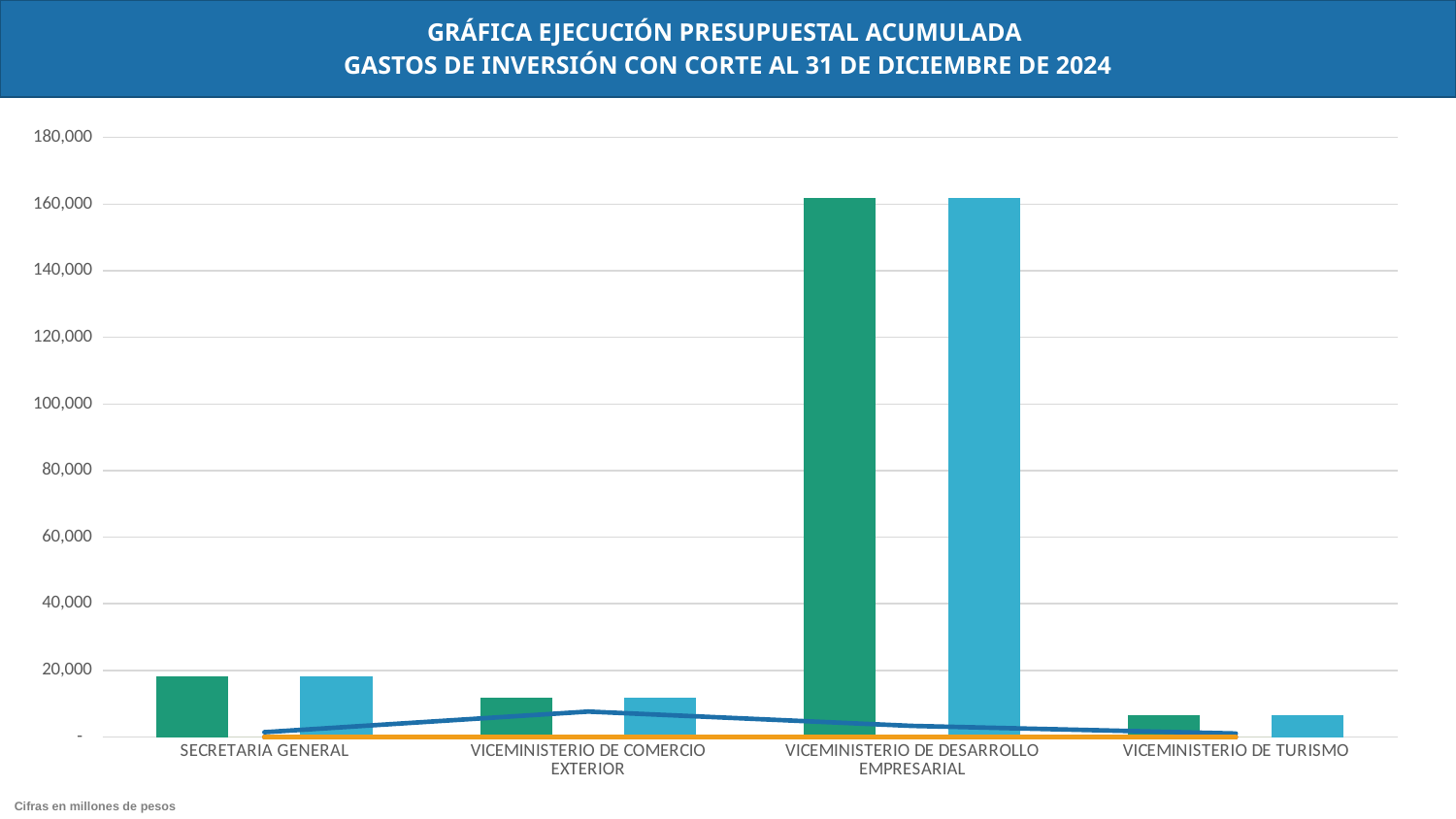
Which has the larger light blue bar, VICEMINISTERIO DE COMERCIO EXTERIOR or VICEMINISTERIO DE TURISMO? VICEMINISTERIO DE COMERCIO EXTERIOR How many categories are shown on the x axis of the chart? 4 Is the value of the green bar for VICEMINISTERIO DE COMERCIO EXTERIOR greater or less than 20,000? less According to the note at the bottom of the slide, in what units are the figures expressed? millones de pesos Which category has the lowest bars in the chart? VICEMINISTERIO DE TURISMO What kind of chart is shown on the slide? combination bar and line chart Is the value of the green bar for VICEMINISTERIO DE DESARROLLO EMPRESARIAL greater or less than 140,000? greater Is the value of the green bar for SECRETARIA GENERAL greater or less than 20,000? less Which category has the highest bars in the chart? VICEMINISTERIO DE DESARROLLO EMPRESARIAL Which has the larger green bar, SECRETARIA GENERAL or VICEMINISTERIO DE COMERCIO EXTERIOR? SECRETARIA GENERAL